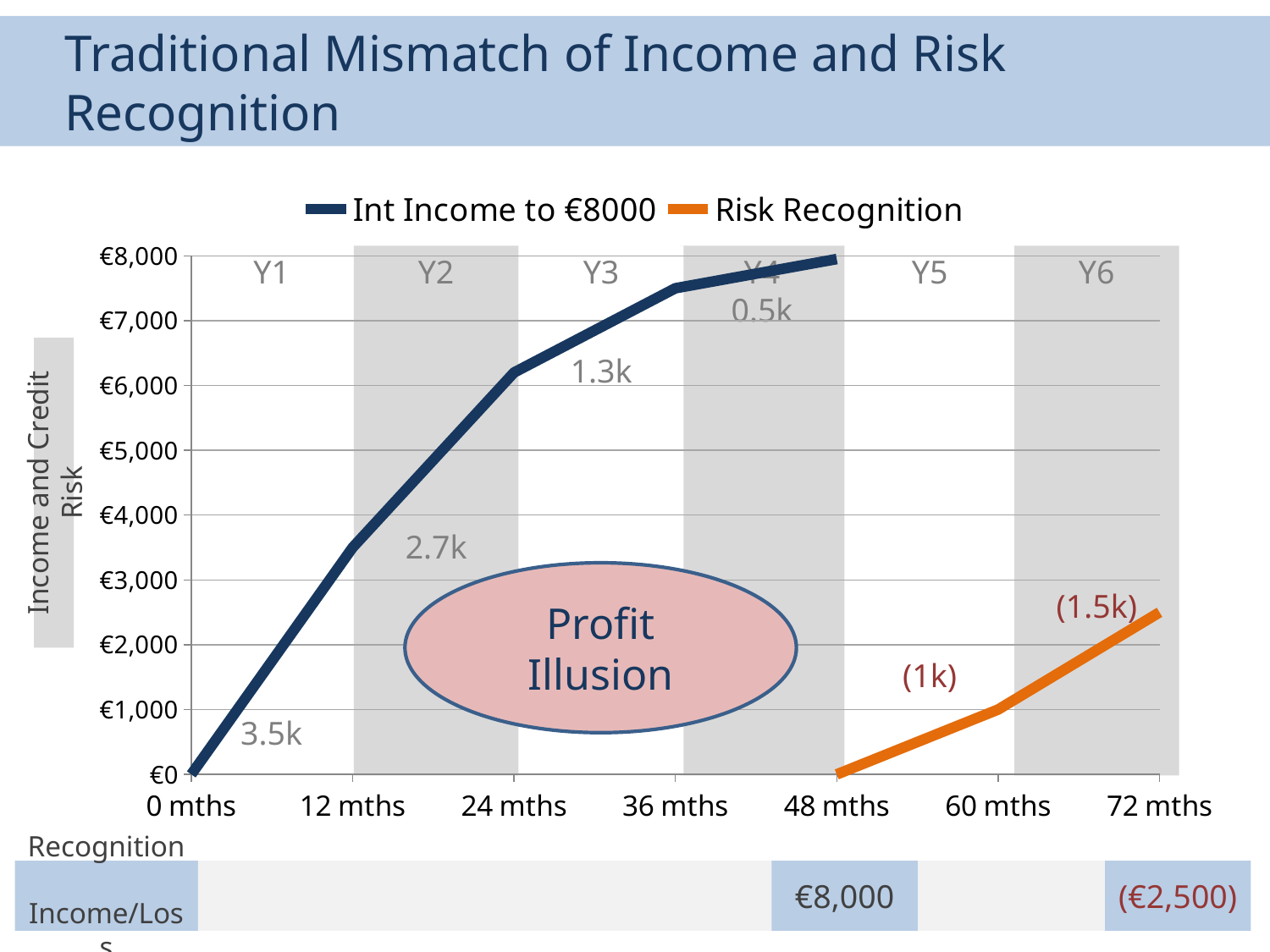
Is the value of Int Income to €8000 at 36 mths greater or less than €7,000? greater How many labelled points are there on the x axis? 7 What are the two series named in the legend? Int Income to €8000 and Risk Recognition Is the value of Risk Recognition at 60 mths greater or less than €2,000? less Which series is drawn in orange? Risk Recognition How many series does the legend list? 2 What is the value of Risk Recognition at 48 mths? €0 Does the Int Income to €8000 line rise or fall from 0 mths to 48 mths? Rises What is the value of Int Income to €8000 at 0 mths? €0 Which is larger: Int Income to €8000 at 36 mths or Risk Recognition at 72 mths? Int Income to €8000 at 36 mths What kind of chart is shown on the slide? Line chart Is the value of Int Income to €8000 at 12 mths greater or less than €3,000? greater